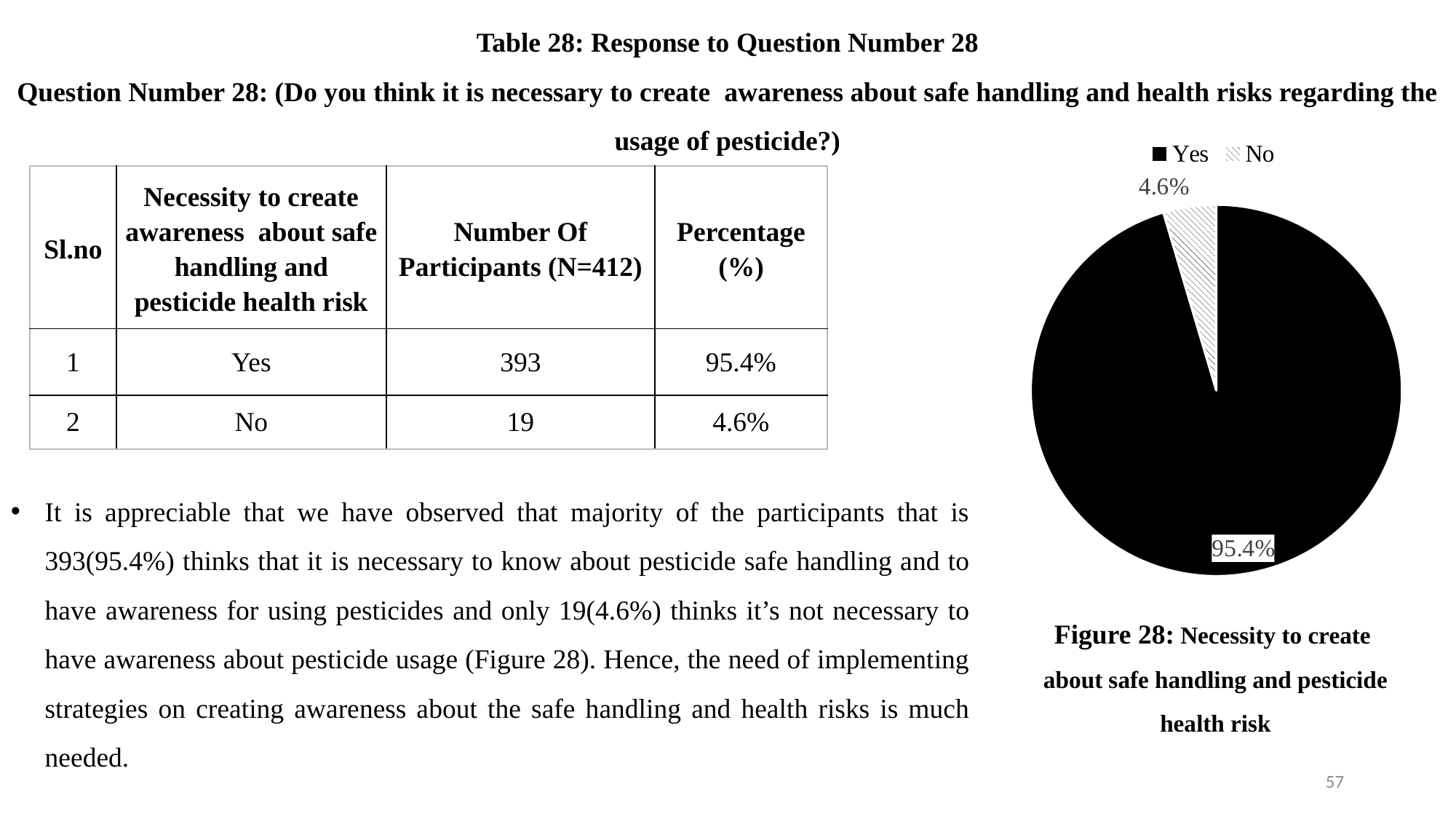
What percentage of the pie chart is labelled for the Yes slice? 95.4% Which slice of the pie chart is the smallest? No How many entries does the legend of the pie chart list? 2 How many slices does the pie chart have? 2 What percentage of the pie chart is labelled for the No slice? 4.6% What kind of chart is shown on the slide? pie chart Which slice of the pie chart is the largest? Yes Which is larger in the pie chart, the Yes slice or the No slice? Yes What is the difference in percentage points between the Yes slice and the No slice in the pie chart? 90.8 What share of the pie does the No slice represent? 4.6% Which legend entry of the pie chart is shown with a hatched pattern? No What is the figure caption of the pie chart? Figure 28: Necessity to create about safe handling and pesticide health risk